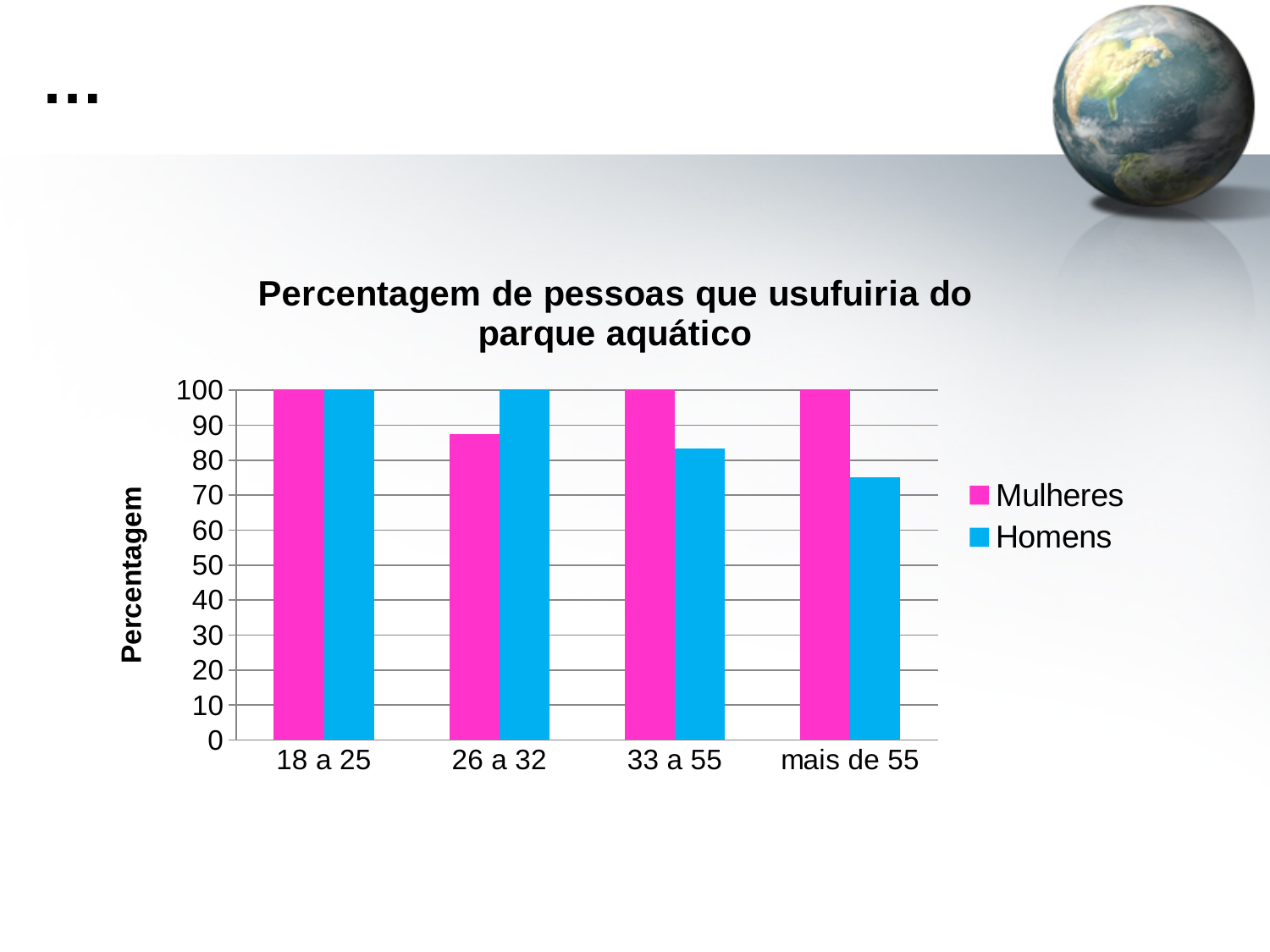
Is the value for Homens in the mais de 55 category greater or less than 80? less In the mais de 55 category, which series has the larger value, Mulheres or Homens? Mulheres Is the value for Mulheres in the 26 a 32 category greater or less than 80? greater Is the value for Homens in the 33 a 55 category greater or less than 90? less What is the value for Mulheres in the 18 a 25 category? 100 How many series does the legend list? 2 Which category has the lowest value for Homens? mais de 55 In the 26 a 32 category, which series has the larger value, Mulheres or Homens? Homens Do the Homens values rise or fall from 26 a 32 to mais de 55? fall How many age categories are shown on the x axis? 4 What is the value for Homens in the 26 a 32 category? 100 What kind of chart is shown on the slide? Bar chart